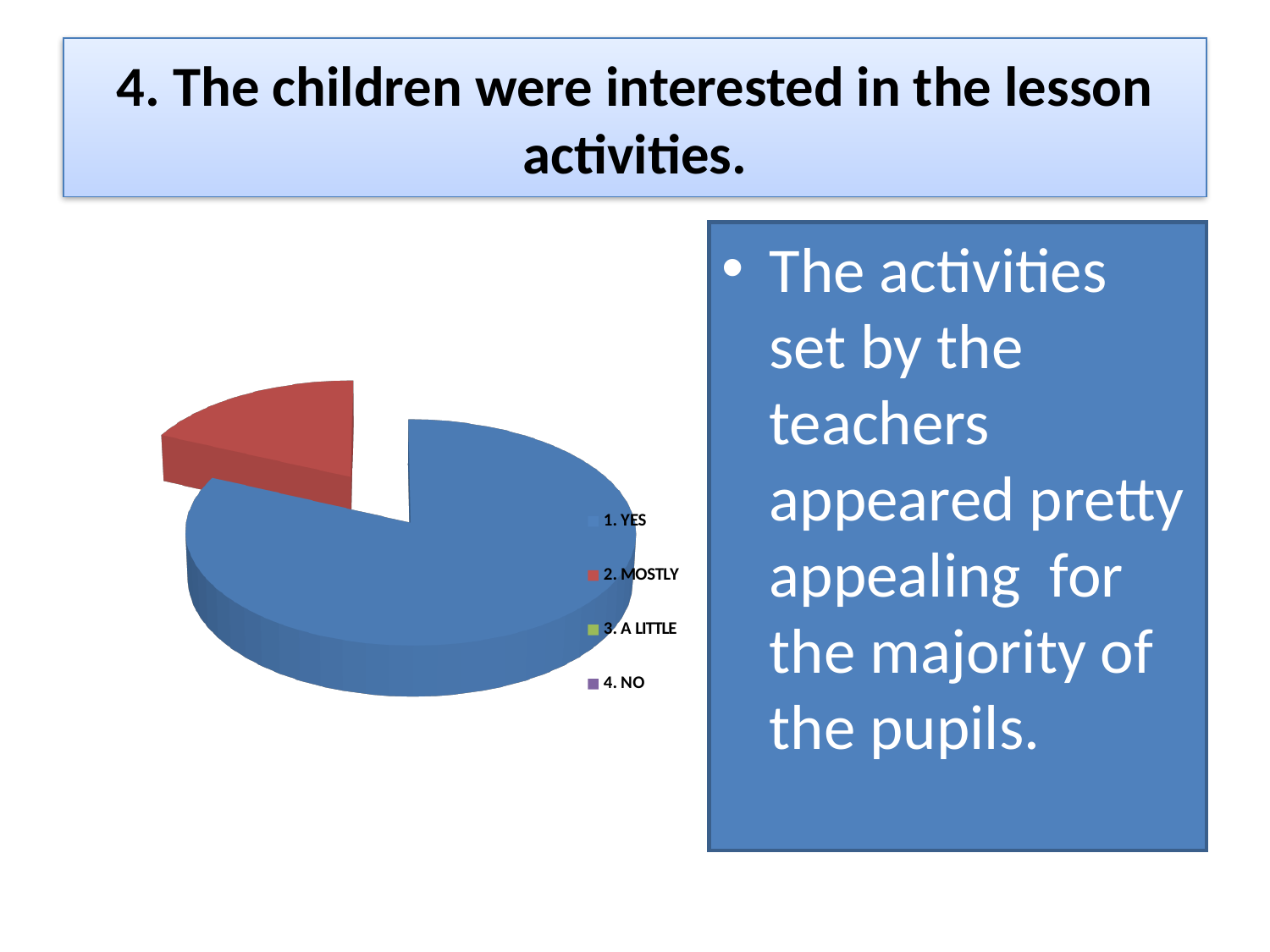
What colour is the slice for 2. MOSTLY? red Does the slice for 1. YES take up more or less than half of the pie? more Which category has the largest slice of the pie? 1. YES How many slices are visibly drawn in the pie? 2 What kind of chart is shown on the slide? pie chart What colour is the slice for 1. YES? blue Which is larger, the slice for 1. YES or the slice for 2. MOSTLY? 1. YES How many entries does the chart's legend list? 4